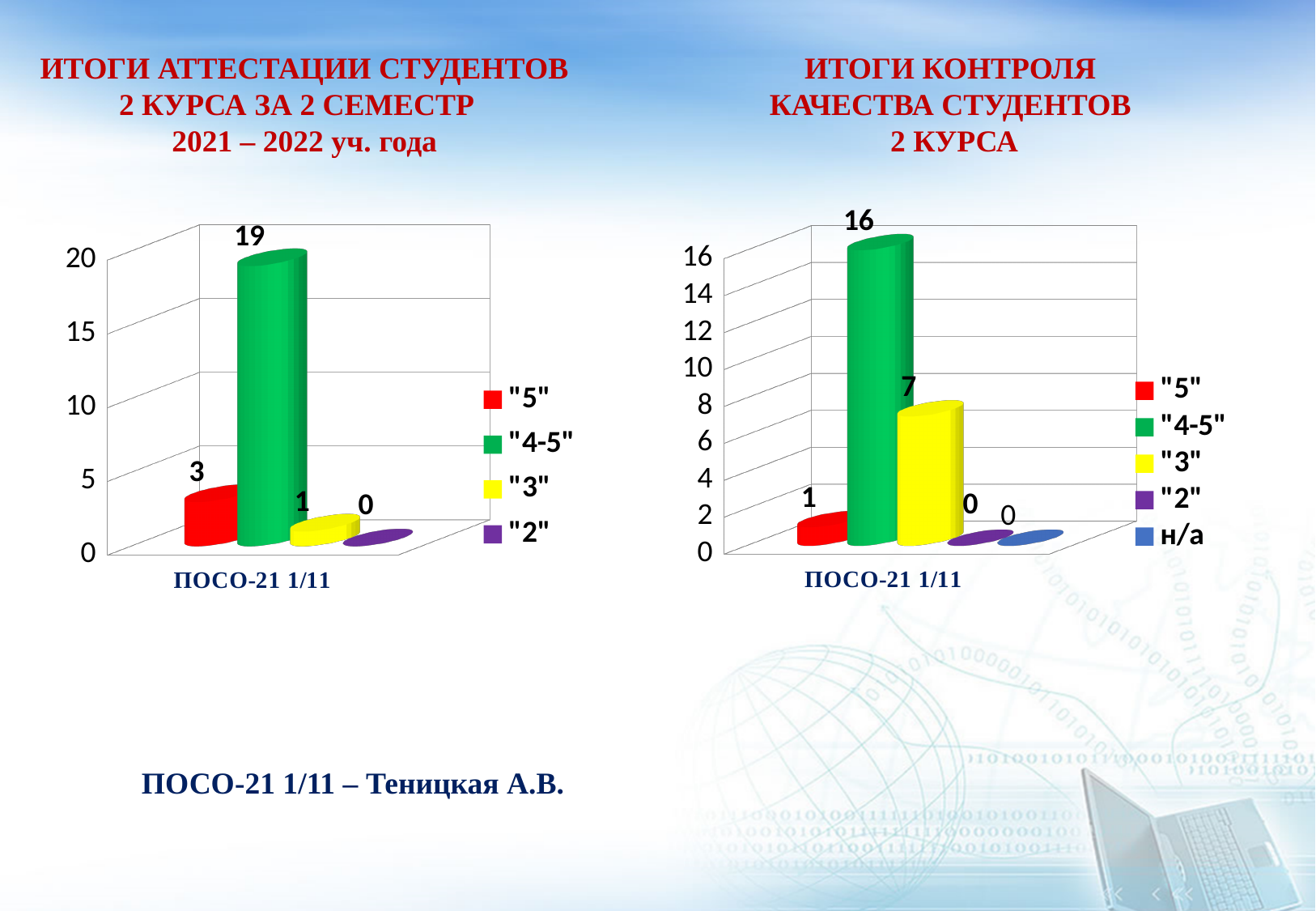
In the left chart (ИТОГИ АТТЕСТАЦИИ СТУДЕНТОВ), which series has the highest value? "4-5" In the left chart (ИТОГИ АТТЕСТАЦИИ СТУДЕНТОВ), what is the difference between the "4-5" value and the "5" value? 16 In the right chart (ИТОГИ КОНТРОЛЯ КАЧЕСТВА СТУДЕНТОВ 2 КУРСА), what is the value for the "3" series? 7 How many series does the legend of the left chart (ИТОГИ АТТЕСТАЦИИ СТУДЕНТОВ) list? 4 In the right chart (ИТОГИ КОНТРОЛЯ КАЧЕСТВА СТУДЕНТОВ), which is larger, the "3" value or the "5" value? "3" In the left chart (ИТОГИ АТТЕСТАЦИИ СТУДЕНТОВ), which series has the lowest value? "2" In the right chart (ИТОГИ КОНТРОЛЯ КАЧЕСТВА СТУДЕНТОВ), what is the value for the "4-5" series? 16 What kind of chart is the right chart (ИТОГИ КОНТРОЛЯ КАЧЕСТВА СТУДЕНТОВ)? Bar chart In the right chart (ИТОГИ КОНТРОЛЯ КАЧЕСТВА СТУДЕНТОВ), what is the difference between the "4-5" value and the "3" value? 9 In the left chart (ИТОГИ АТТЕСТАЦИИ СТУДЕНТОВ 2 КУРСА ЗА 2 СЕМЕСТР), what is the value for the "4-5" series? 19 How many series does the legend of the right chart (ИТОГИ КОНТРОЛЯ КАЧЕСТВА СТУДЕНТОВ) list? 5 In the left chart (ИТОГИ АТТЕСТАЦИИ СТУДЕНТОВ), what is the value for the "5" series? 3